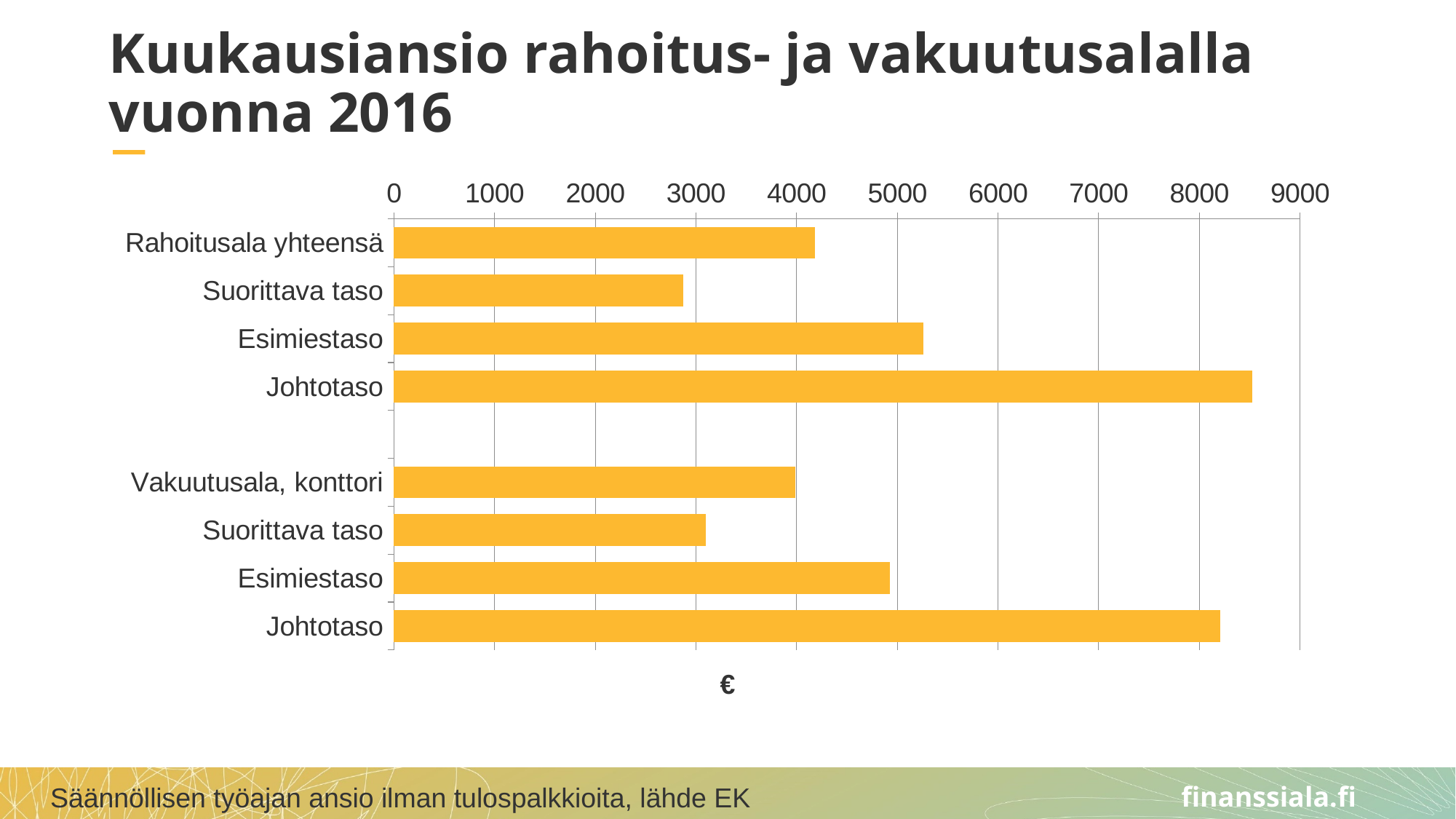
Which is larger: Johtotaso in the Rahoitusala group or Johtotaso in the Vakuutusala group? Johtotaso in the Rahoitusala group Is the value for Esimiestaso in the Rahoitusala group greater or less than 5000? greater Is the value for Suorittava taso in the Rahoitusala group greater or less than 3000? less Is the value for Rahoitusala yhteensä greater or less than 4000? greater What unit is shown on the horizontal axis of the chart? € How many bars are plotted in the chart? 8 What kind of chart is shown on the slide? Bar chart Which category has the highest monthly earnings in the chart? Johtotaso (Rahoitusala) Which category has the lowest monthly earnings in the chart? Suorittava taso (Rahoitusala) Which is larger: Esimiestaso in the Rahoitusala group or Esimiestaso in the Vakuutusala group? Esimiestaso in the Rahoitusala group